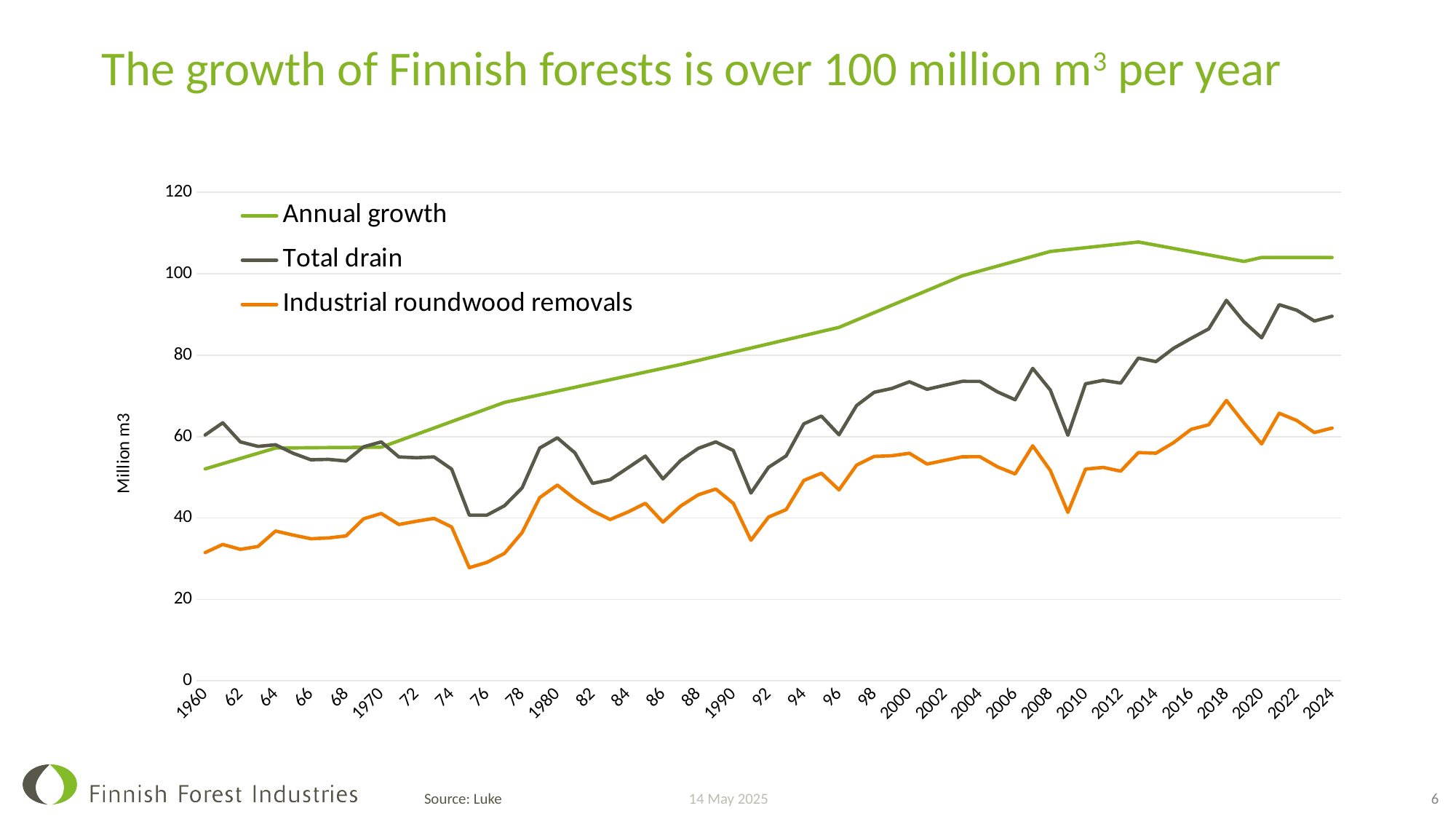
In 1960, which is larger: Total drain or Annual growth? Total drain Does the Annual growth line rise or fall from 1960 to 2024? rises What is the label on the vertical axis of the chart? Million m3 Is the value for Annual growth in 2024 greater or less than 100? greater How many series does the legend list? 3 Which series has the highest value in 2024? Annual growth In 2024, which is larger: Annual growth or Total drain? Annual growth Is the value for Total drain in 2018 greater or less than 80? greater What kind of chart is shown on the slide? Line chart Is the value for Industrial roundwood removals in 1976 greater or less than 40? less